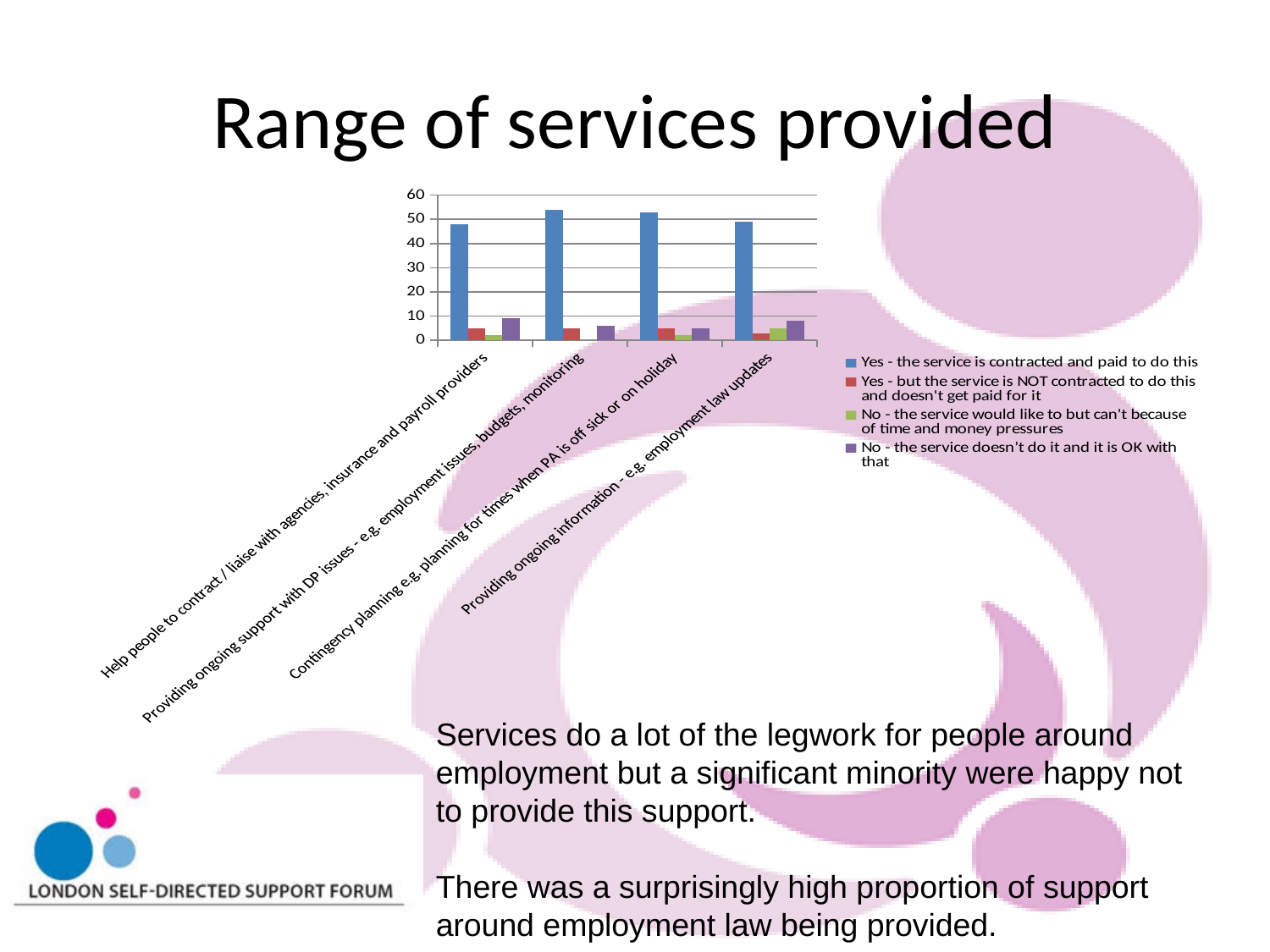
For 'Help people to contract / liaise with agencies, insurance and payroll providers', which is larger: the value for 'Yes - the service is contracted and paid to do this' or the value for 'No - the service doesn't do it and it is OK with that'? Yes - the service is contracted and paid to do this How many categories are shown on the x axis of the chart? 4 Which series has the highest value in every category of the chart? Yes - the service is contracted and paid to do this For 'Help people to contract / liaise with agencies, insurance and payroll providers', which is larger: the value for 'No - the service would like to but can't because of time and money pressures' or the value for 'No - the service doesn't do it and it is OK with that'? No - the service doesn't do it and it is OK with that Is the value for 'Yes - the service is contracted and paid to do this' for 'Providing ongoing support with DP issues - e.g. employment issues, budgets, monitoring' greater or less than 50? greater What is the title of the slide containing the chart? Range of services provided How many series does the chart's legend list? 4 Is the value for 'Yes - the service is contracted and paid to do this' for 'Providing ongoing information - e.g. employment law updates' greater or less than 40? greater Is the value for 'Yes - but the service is NOT contracted to do this and doesn't get paid for it' for 'Contingency planning e.g. planning for times when PA is off sick or on holiday' greater or less than 10? less Which legend entry is shown in blue? Yes - the service is contracted and paid to do this What kind of chart is shown on the slide? bar chart